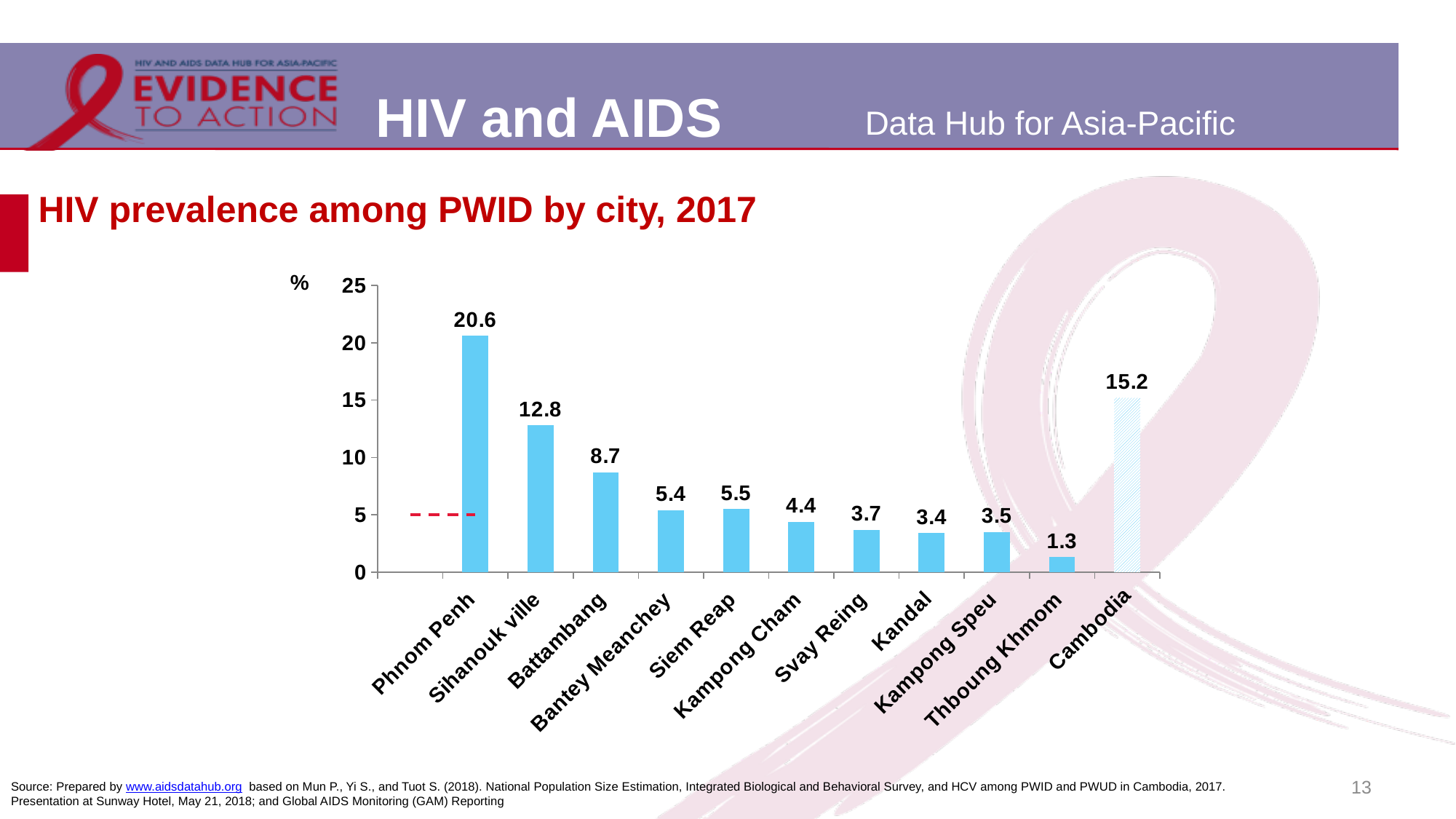
Which city has the lowest HIV prevalence among PWID? Thboung Khmom What is the value shown for Thboung Khmom? 1.3 What is the title of the chart? HIV prevalence among PWID by city, 2017 How many categories are shown on the x axis? 11 What is the difference between the values for Phnom Penh and Sihanouk ville? 7.8 What is the HIV prevalence among PWID in Phnom Penh? 20.6 What is the value shown for Battambang? 8.7 Which has a higher value, Kampong Cham or Svay Reing? Kampong Cham Is the value for Sihanouk ville greater or less than 10? greater What kind of chart is shown on the slide? Bar chart Which city has the highest HIV prevalence among PWID? Phnom Penh What is the value shown for Cambodia? 15.2